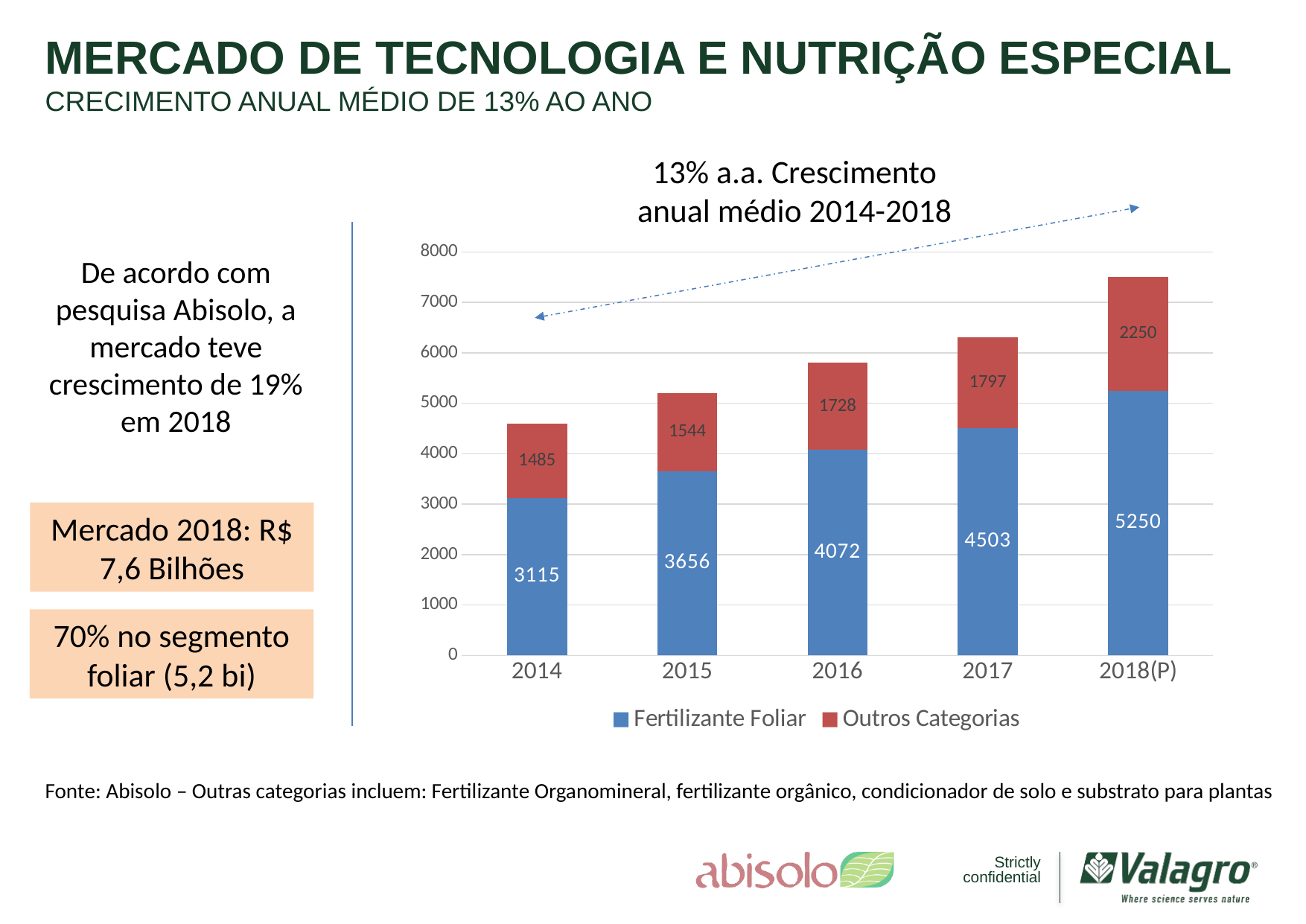
What is the total of the stacked bar for 2018(P)? 7500 What is the value for Fertilizante Foliar in 2016? 4072 Which year has the lowest value for Fertilizante Foliar? 2014 What is the value for Outros Categorias in 2015? 1544 What is the total of the stacked bar for 2014? 4600 How many years are shown on the x axis? 5 Which year has the highest value for Outros Categorias? 2018(P) What is the value for Fertilizante Foliar in 2018(P)? 5250 Which is larger: Outros Categorias in 2017 or Outros Categorias in 2016? 2017 Do the Fertilizante Foliar values rise or fall from 2014 to 2018(P)? rise How many series does the legend list? 2 What is the difference between the Fertilizante Foliar values for 2017 and 2016? 431